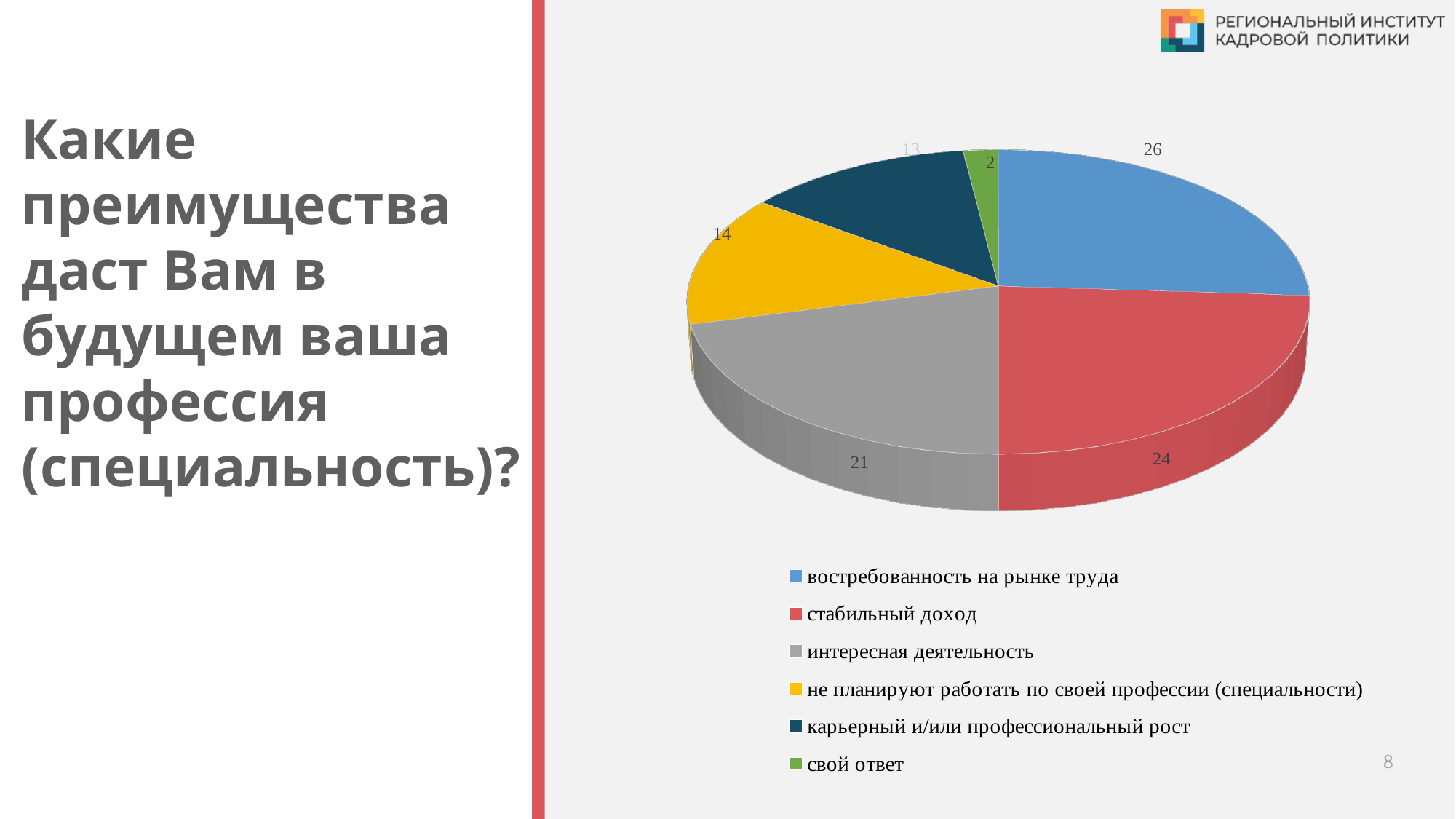
What value is shown for «карьерный и/или профессиональный рост»? 13 What value is shown for «востребованность на рынке труда»? 26 Which category has the largest slice of the pie? востребованность на рынке труда What type of chart is shown on the slide? pie chart Which is larger: the value for «не планируют работать по своей профессии (специальности)» or the value for «карьерный и/или профессиональный рост»? не планируют работать по своей профессии (специальности) How many categories does the pie chart contain? 6 What is the difference between the values for «востребованность на рынке труда» and «стабильный доход»? 2 What value is shown for «интересная деятельность»? 21 Which category has the smallest slice of the pie? свой ответ What colour is the slice for «стабильный доход»? red What value is shown for «стабильный доход»? 24 What is the total of all the values shown on the pie chart? 100